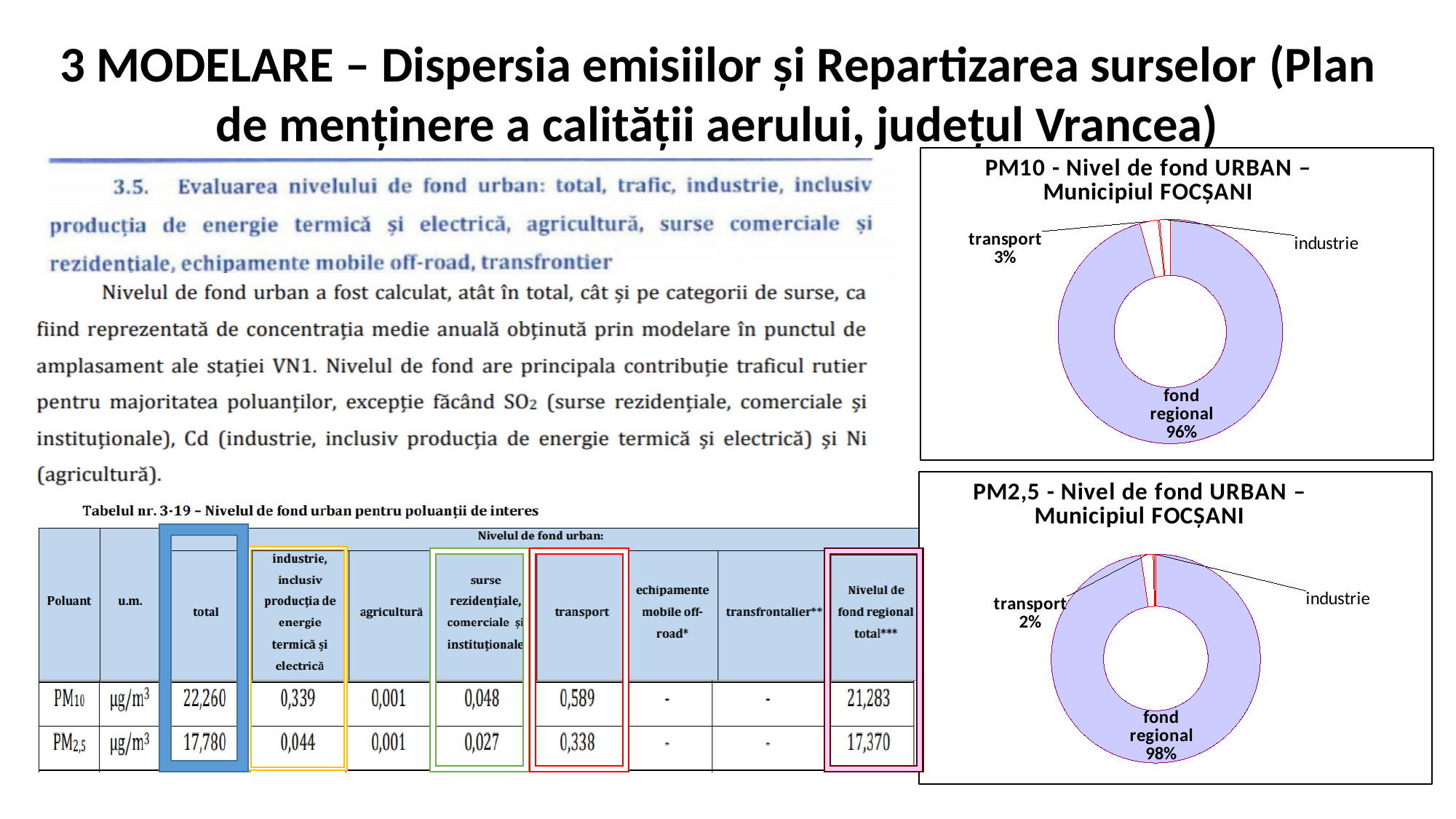
In the chart titled "PM2,5 - Nivel de fond URBAN – Municipiul FOCȘANI", what share does "fond regional" have? 98% In the chart titled "PM2,5 - Nivel de fond URBAN – Municipiul FOCȘANI", which category has the largest slice? fond regional In the chart titled "PM10 - Nivel de fond URBAN – Municipiul FOCȘANI", what is the difference in percentage points between the "fond regional" share and the "transport" share? 93 percentage points In the chart titled "PM2,5 - Nivel de fond URBAN – Municipiul FOCȘANI", what is the difference in percentage points between the "fond regional" share and the "transport" share? 96 percentage points In the chart titled "PM10 - Nivel de fond URBAN – Municipiul FOCȘANI", which category has the largest slice? fond regional What kind of chart is the "PM10 - Nivel de fond URBAN – Municipiul FOCȘANI" chart? Doughnut (pie) chart How many category labels are shown on the "PM2,5 - Nivel de fond URBAN – Municipiul FOCȘANI" chart? 3 In the chart titled "PM2,5 - Nivel de fond URBAN – Municipiul FOCȘANI", what share does "transport" have? 2% In the chart titled "PM10 - Nivel de fond URBAN – Municipiul FOCȘANI", what share does "transport" have? 3% Which chart shows a larger share for "transport": the PM10 chart or the PM2,5 chart? The PM10 chart In the chart titled "PM10 - Nivel de fond URBAN – Municipiul FOCȘANI", which category is labelled but shows no percentage value? industrie